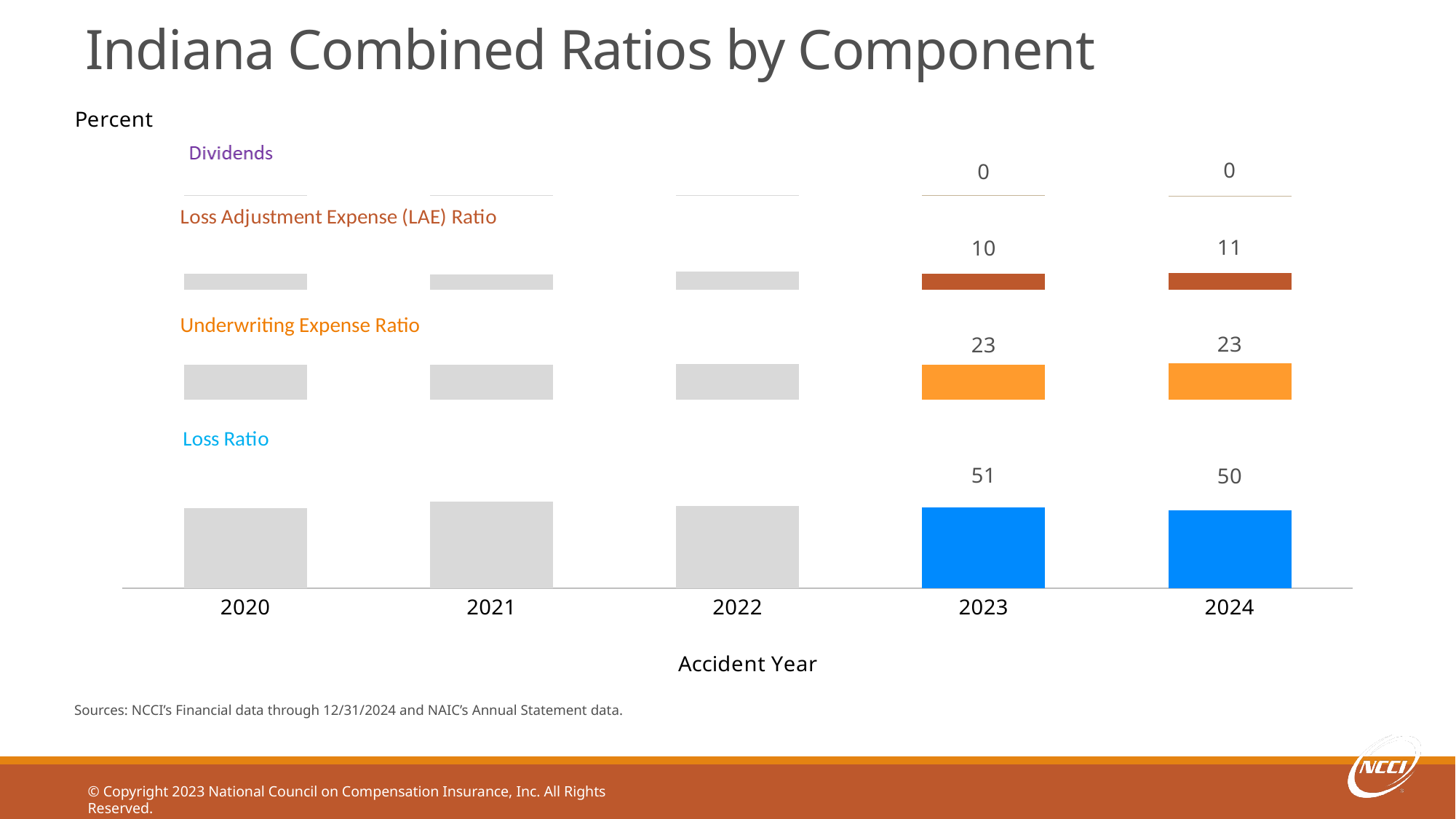
What is the Loss Adjustment Expense (LAE) Ratio for accident year 2023? 10 What is the total combined ratio for accident year 2024, summing the four labeled components? 84 What type of chart is shown on the slide? Bar chart Which year has the higher Loss Adjustment Expense (LAE) Ratio, 2023 or 2024? 2024 What is the Loss Ratio for accident year 2024? 50 What is the total combined ratio for accident year 2023, summing the four labeled components? 84 What is the Underwriting Expense Ratio for accident year 2024? 23 What is the Loss Ratio for accident year 2023? 51 How many components are shown in the chart? 4 How many accident years are shown on the x axis? 5 What is the Dividends value for accident year 2024? 0 What is the difference between the Loss Ratio in 2023 and in 2024? 1